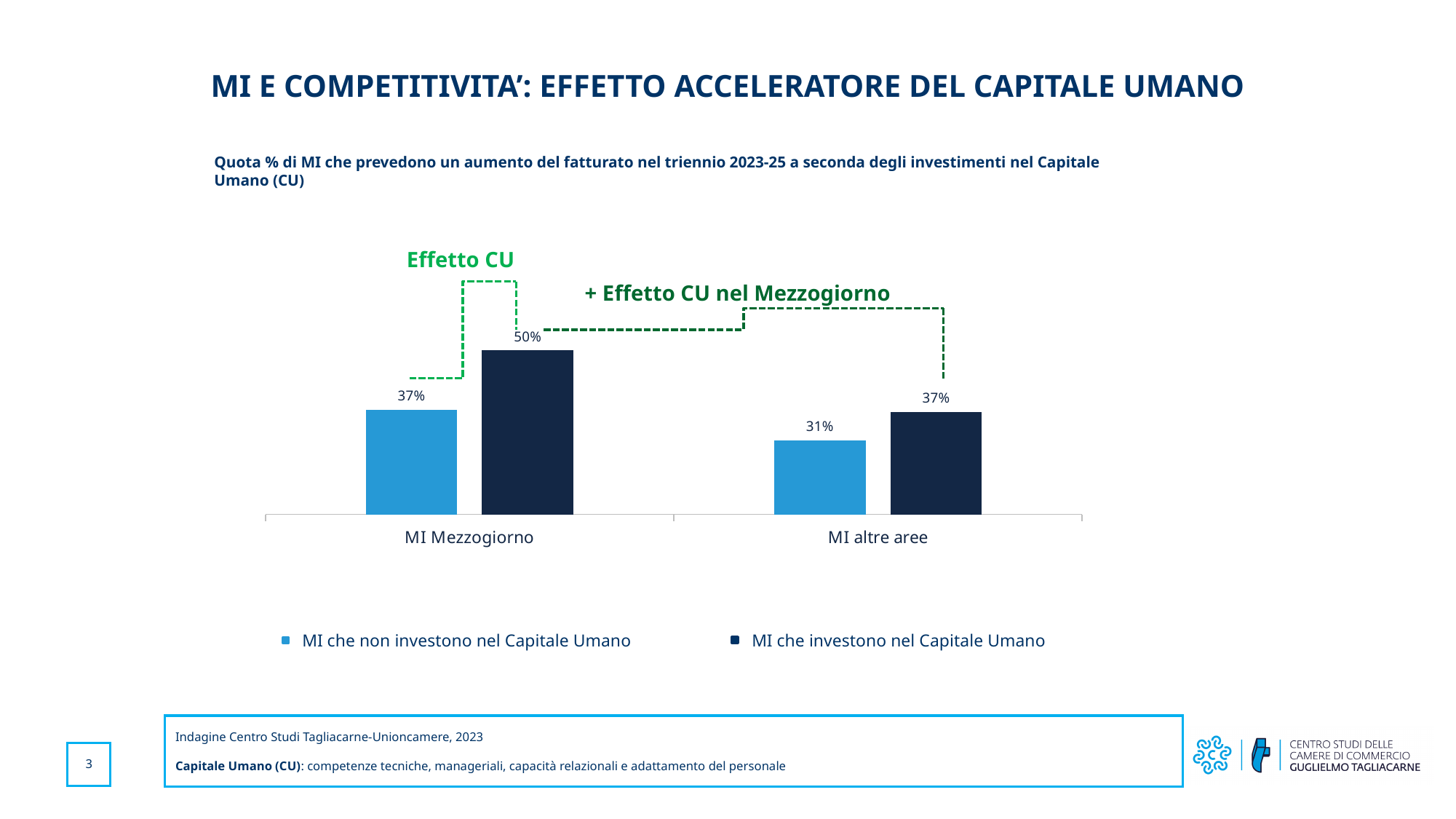
What is the value for MI che investono nel Capitale Umano in MI Mezzogiorno? 50% How many categories are shown on the x axis? 2 Which bar has the lowest value on the chart? MI che non investono nel Capitale Umano, MI altre aree What kind of chart is shown on the slide? Bar chart Which bar has the highest value on the chart? MI che investono nel Capitale Umano, MI Mezzogiorno Which is larger: MI che non investono nel Capitale Umano in MI Mezzogiorno or MI che investono nel Capitale Umano in MI altre aree? They are equal (37%) What is the difference between MI che investono and MI che non investono nel Capitale Umano in MI Mezzogiorno? 13% What is the value for MI che investono nel Capitale Umano in MI altre aree? 37% What is the value for MI che non investono nel Capitale Umano in MI Mezzogiorno? 37% What is the difference between MI che investono and MI che non investono nel Capitale Umano in MI altre aree? 6% What is the value for MI che non investono nel Capitale Umano in MI altre aree? 31% How many series does the legend list? 2